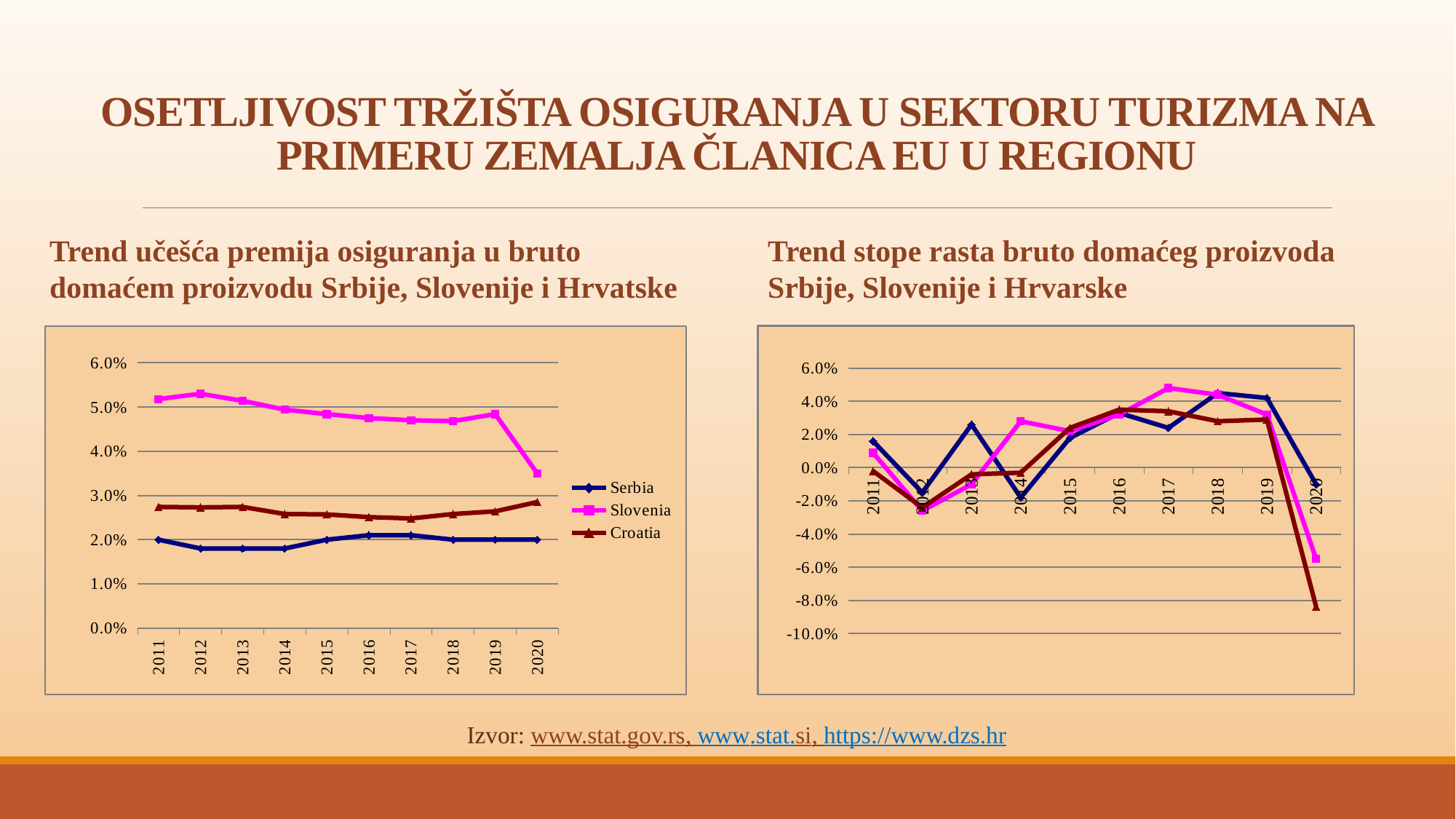
In the left chart, is the value for Slovenia in 2012 greater or less than 5.0%? greater How many years are shown on the x axis of the left chart? 10 In the left chart, which is larger in 2019: the value for Croatia or the value for Serbia? Croatia In the left chart, which country has the highest insurance premium share of GDP in 2012? Slovenia What kind of chart is the left chart, 'Trend učešća premija osiguranja u bruto domaćem proizvodu Srbije, Slovenije i Hrvatske'? Line chart In the right chart, is the value of the dark red line in 2020 greater or less than -8.0%? less In the left chart, is the value for Slovenia in 2020 greater or less than 4.0%? less How many series does the legend of the left chart list? 3 In the left chart, does the Slovenia line rise or fall between 2019 and 2020? Fall In the left chart, which country has the lowest value in 2016? Serbia How many years are shown on the x axis of the right chart, 'Trend stope rasta bruto domaćeg proizvoda Srbije, Slovenije i Hrvarske'? 10